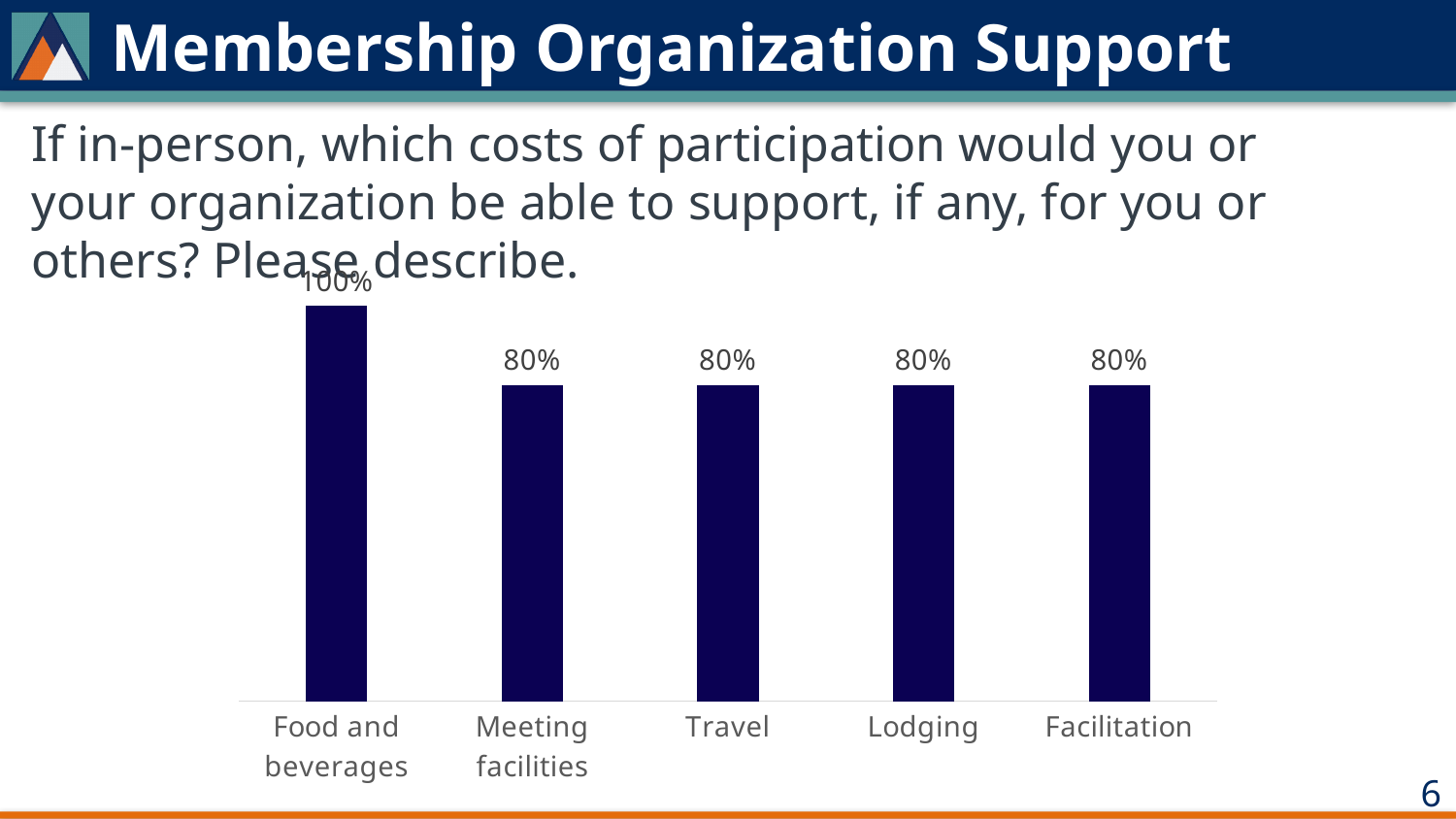
What is the value for Travel? 80% How many categories are shown in the chart? 5 What kind of chart is shown on the slide? Bar chart Which is larger, the value for Food and beverages or the value for Lodging? Food and beverages What colour are the bars in the chart? Dark navy blue What is the difference between the values for Food and beverages and Meeting facilities? 20% How many categories have a value of 80%? 4 What is the value for Food and beverages? 100% What is the value for Facilitation? 80% What is the value for Lodging? 80% What is the label of the first category on the left of the chart? Food and beverages Which category has the highest value? Food and beverages